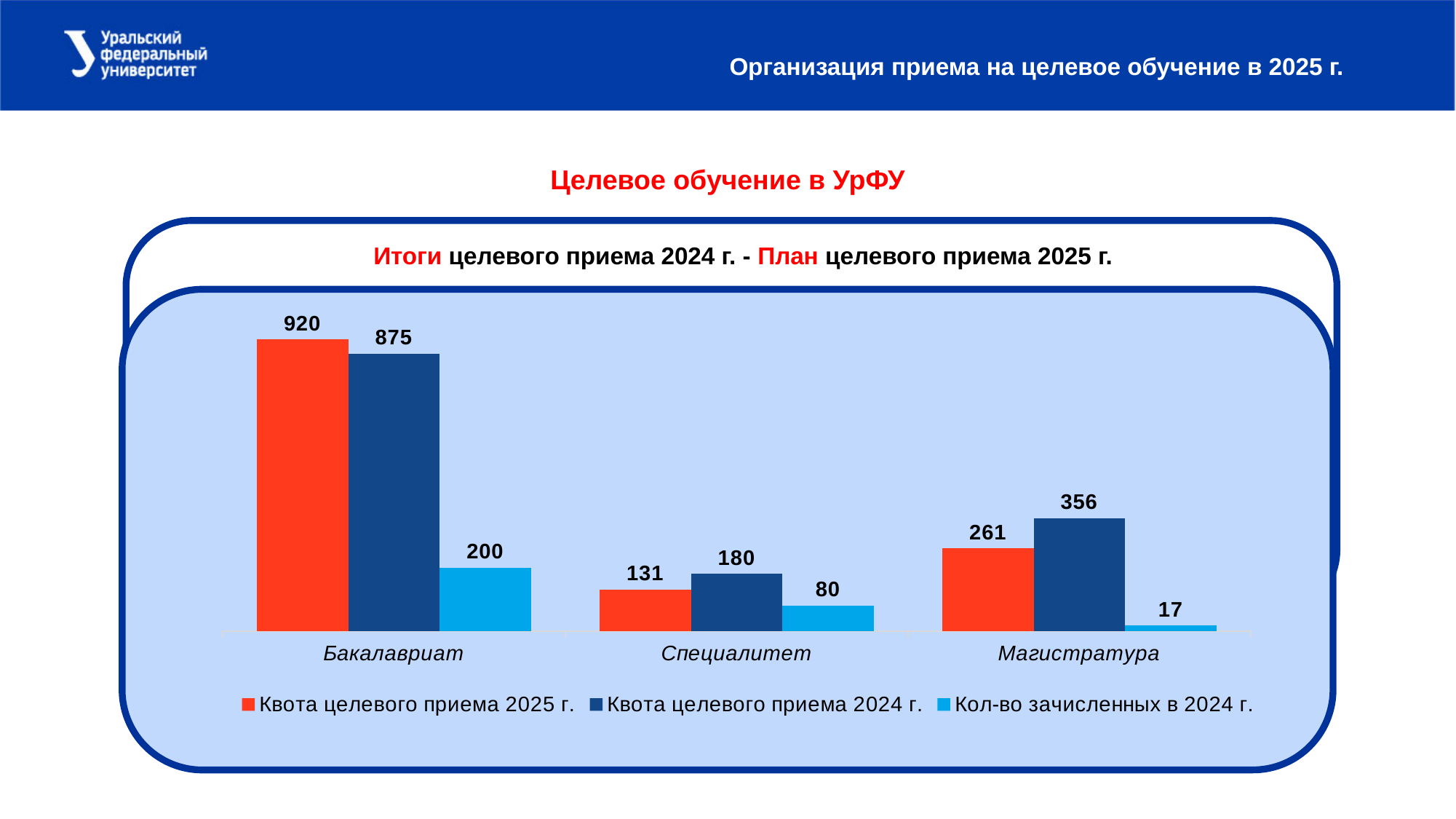
What is the value of 'Квота целевого приема 2024 г.' for Специалитет? 180 What is the difference between 'Квота целевого приема 2024 г.' and 'Кол-во зачисленных в 2024 г.' for Специалитет? 100 What kind of chart is shown on the slide? Bar chart For Магистратура, which is larger: 'Квота целевого приема 2025 г.' or 'Квота целевого приема 2024 г.'? Квота целевого приема 2024 г. How many series does the legend list? 3 What colour are the bars for 'Кол-во зачисленных в 2024 г.'? Light blue Which category has the lowest value for 'Кол-во зачисленных в 2024 г.'? Магистратура What is the value of 'Квота целевого приема 2025 г.' for Бакалавриат? 920 How many categories are shown on the x axis? 3 What is the value of 'Кол-во зачисленных в 2024 г.' for Магистратура? 17 Which category has the highest value for 'Квота целевого приема 2024 г.'? Бакалавриат What is the difference between 'Квота целевого приема 2025 г.' and 'Квота целевого приема 2024 г.' for Бакалавриат? 45